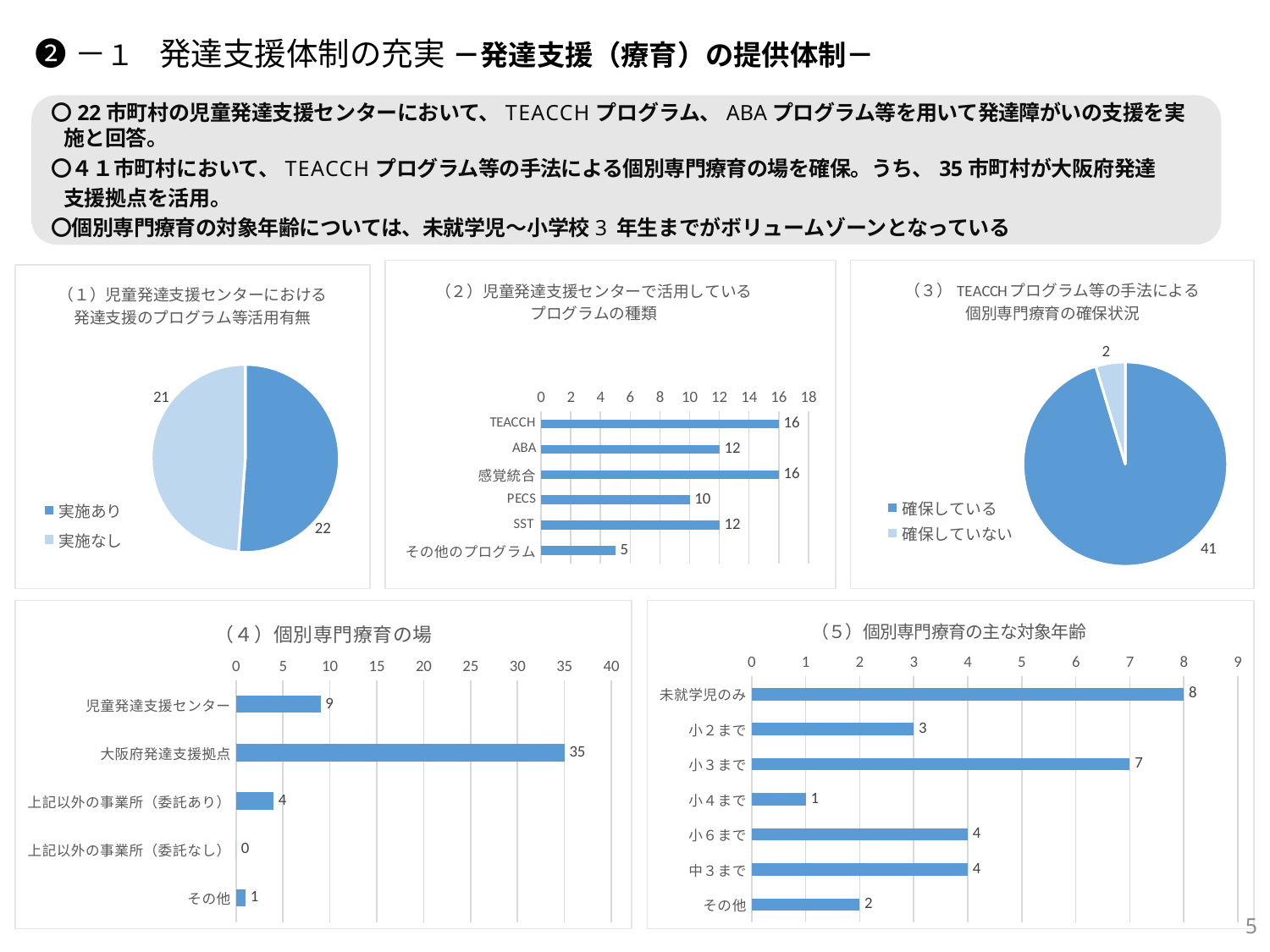
In chart (1) 児童発達支援センターにおける発達支援のプログラム等活用有無, what is the value for 実施あり? 22 In chart (2) 児童発達支援センターで活用しているプログラムの種類, how many programs are listed? 6 In chart (2) 児童発達支援センターで活用しているプログラムの種類, which program has the lowest value? その他のプログラム In chart (2) 児童発達支援センターで活用しているプログラムの種類, what is the value for PECS? 10 In chart (5) 個別専門療育の主な対象年齢, how many categories are shown? 7 In chart (1) 児童発達支援センターにおける発達支援のプログラム等活用有無, what kind of chart is shown? Pie chart In chart (4) 個別専門療育の場, what is the difference between 大阪府発達支援拠点 and 児童発達支援センター? 26 In chart (5) 個別専門療育の主な対象年齢, which is larger, 未就学児のみ or 小３まで? 未就学児のみ In chart (4) 個別専門療育の場, which category has the highest value? 大阪府発達支援拠点 In chart (3) TEACCHプログラム等の手法による個別専門療育の確保状況, what is the total of the two slices? 43 In chart (3) TEACCHプログラム等の手法による個別専門療育の確保状況, what is the value for 確保していない? 2 In chart (4) 個別専門療育の場, what kind of chart is shown? Bar chart